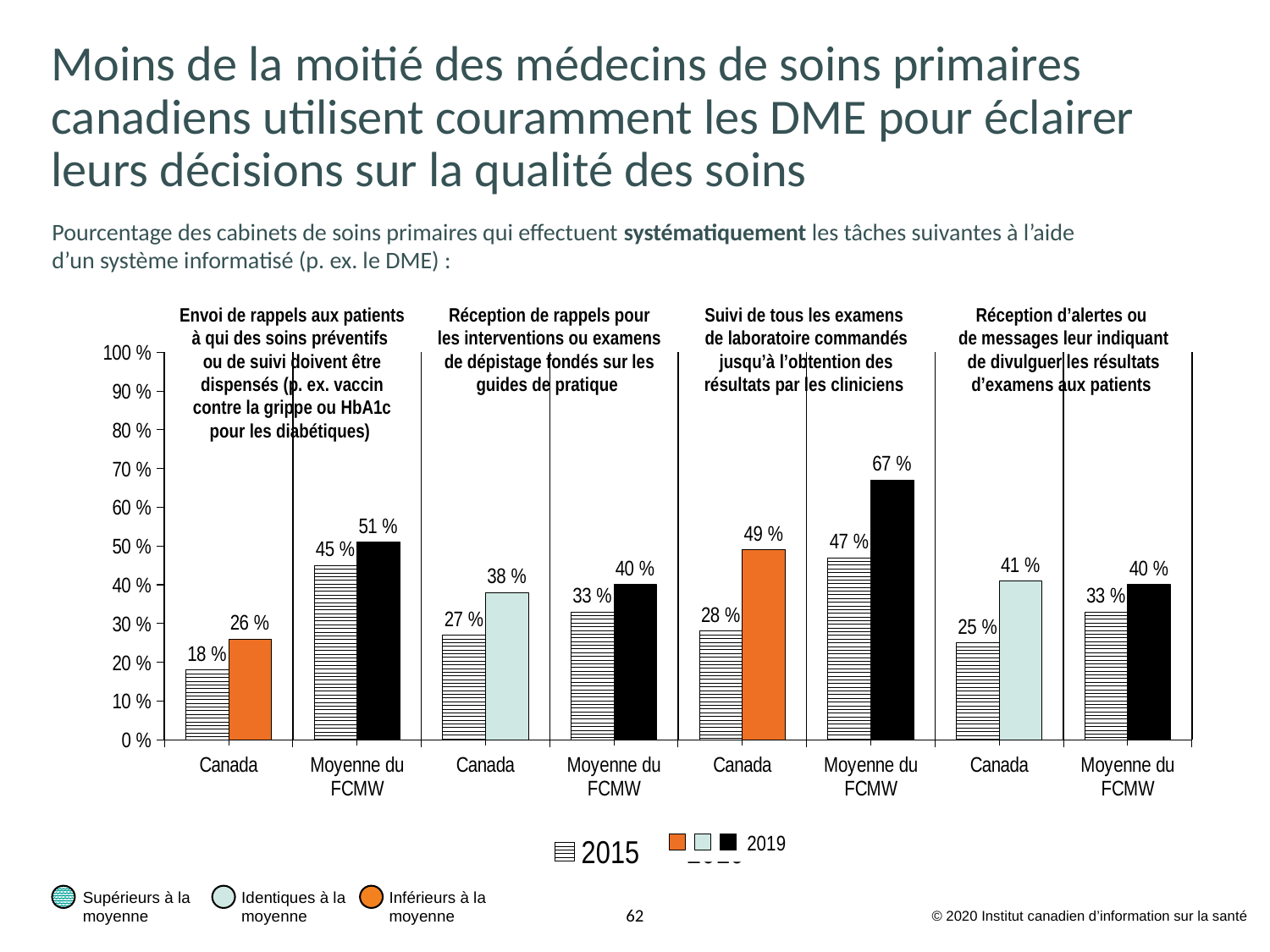
How many series does the legend list? 2 Does Canada's value rise or fall from 2015 to 2019 in the 'Réception de rappels pour les interventions ou examens de dépistage' panel? Rise Which bar has the highest value on the chart? Moyenne du FCMW, 2019, Suivi de tous les examens de laboratoire commandés (67 %) Which bar has the lowest value on the chart? Canada, 2015, Envoi de rappels aux patients (18 %) In the 'Envoi de rappels aux patients' panel, by how much did Canada's value increase from 2015 to 2019? 8 % In the 'Réception d'alertes ou de messages' panel, which is larger in 2019: Canada or Moyenne du FCMW? Canada What is the 2015 value for Canada in the 'Envoi de rappels aux patients' panel? 18 % In the 'Suivi de tous les examens de laboratoire commandés' panel, what is the difference between the 2019 values for Moyenne du FCMW and Canada? 18 % What kind of chart is shown on the slide? Bar chart What is the 2019 value for Canada in the 'Suivi de tous les examens de laboratoire commandés' panel? 49 % Is the 2019 value for Moyenne du FCMW in the 'Suivi de tous les examens de laboratoire commandés' panel greater or less than 60 %? greater What is the 2019 value for Moyenne du FCMW in the 'Réception d'alertes ou de messages' panel? 40 %